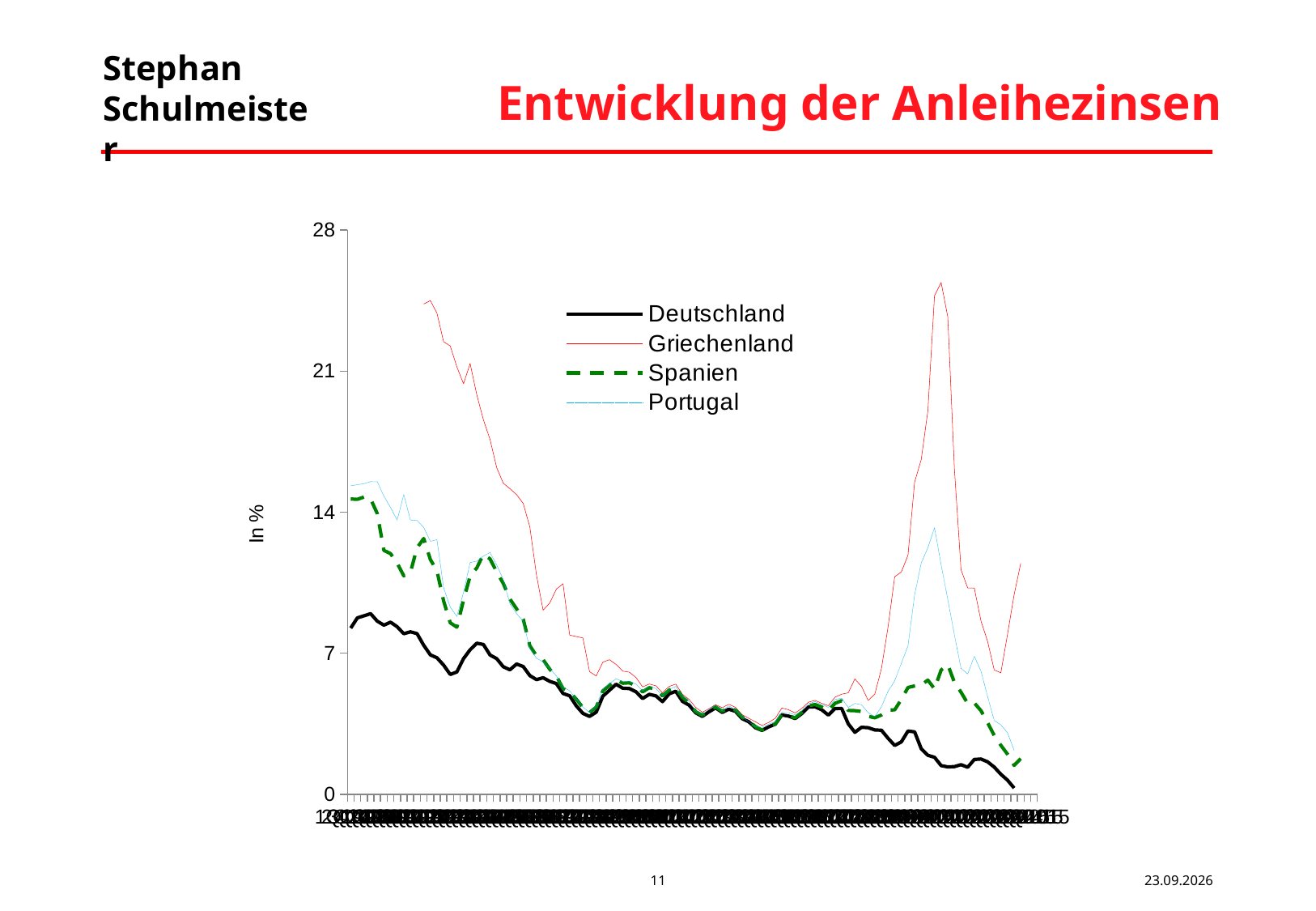
At the tall spike near the right side of the chart, which series is higher: Griechenland or Deutschland? Griechenland Does the Deutschland series generally rise or fall from left to right across the chart? fall What kind of chart is shown on the slide? line chart What is the title of the chart? Entwicklung der Anleihezinsen Is the value of the Griechenland series at the left end of the chart greater or less than 21? greater Is the peak value of the Griechenland series greater or less than 21? greater How many series does the legend list? 4 Is the highest value of the Deutschland series greater or less than 14? less Which series reaches the highest value anywhere on the chart? Griechenland Which series is drawn as a green dashed line? Spanien What is the label on the vertical axis? In %